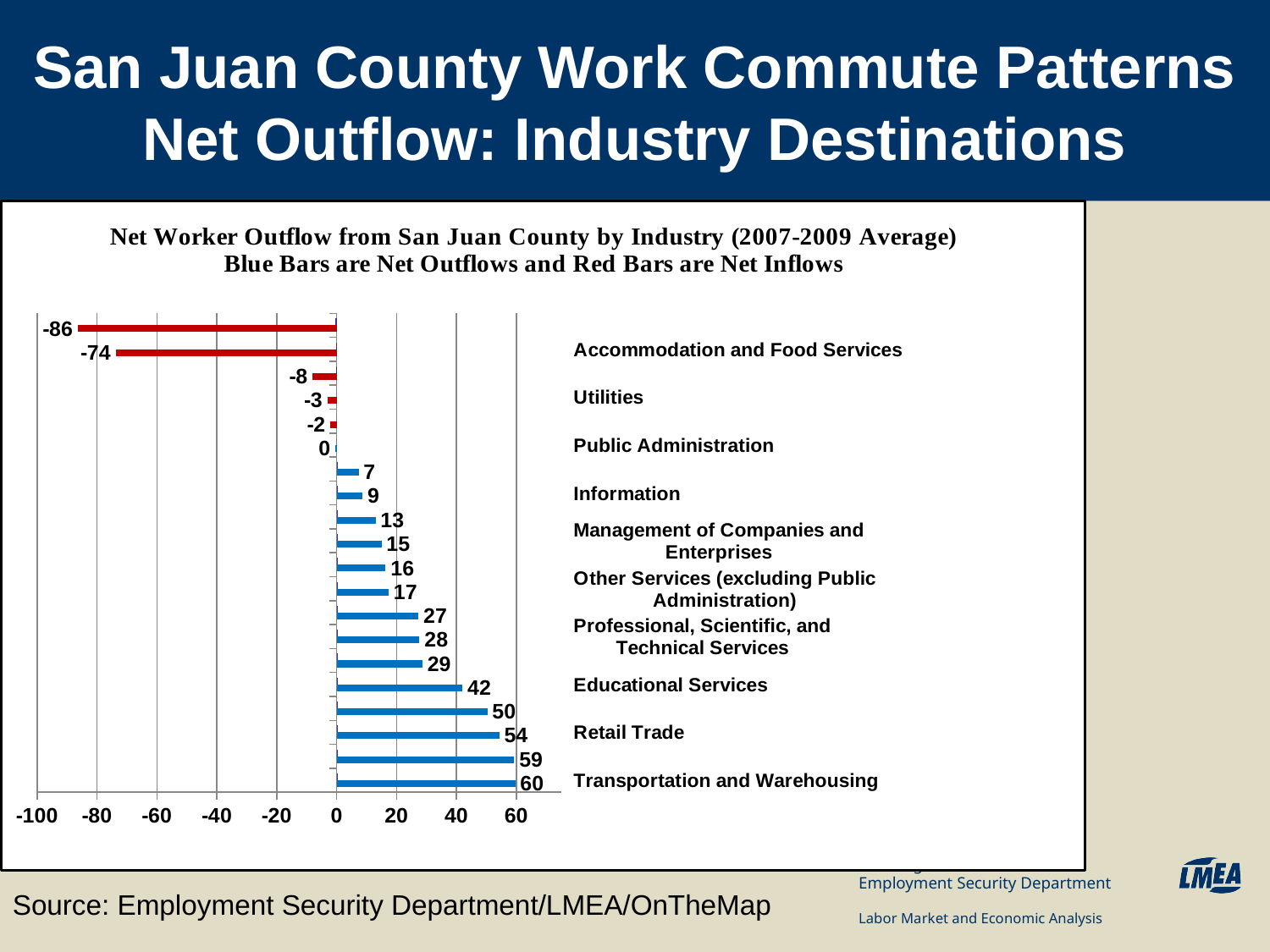
According to the chart subtitle, what do the red bars represent? Net Inflows What is the title of the chart? Net Worker Outflow from San Juan County by Industry (2007-2009 Average) How many bars are plotted in the chart? 20 How many bars in the chart have negative values? 5 What is the difference between the values for Transportation and Warehousing and Retail Trade? 6 What kind of chart is shown on the slide? bar chart What is the value for Educational Services? 42 Which has a larger value, Retail Trade or Educational Services? Retail Trade What is the largest value shown in the chart? 60 What is the smallest (most negative) value shown in the chart? -86 What is the value for Transportation and Warehousing? 60 What is the value for Retail Trade? 54